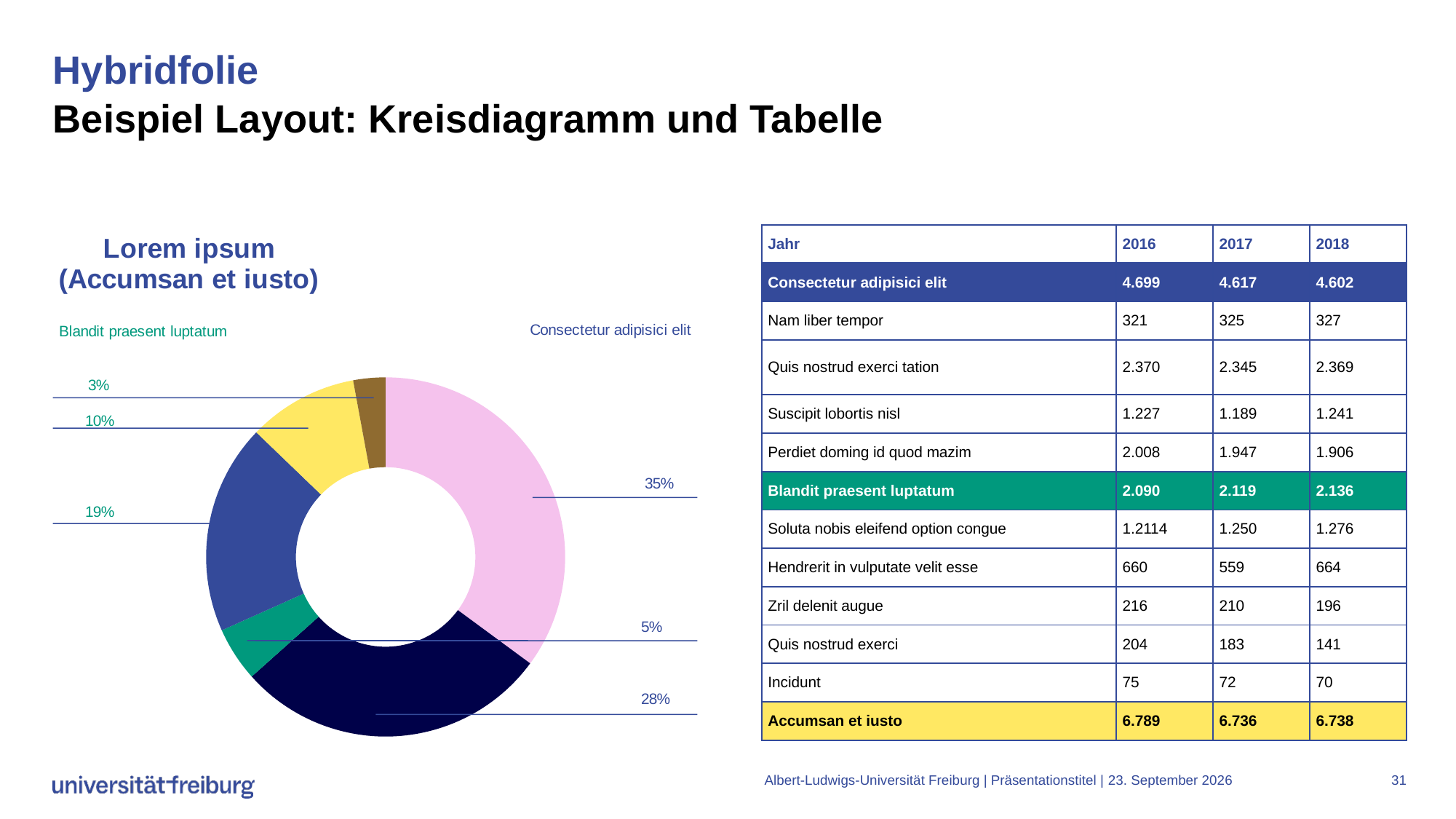
What colour is the 35% slice of the pie chart? pink In the pie chart, which is larger: the 19% slice or the 10% slice? 19% What is the difference between the largest slice (35%) and the second largest slice (28%) in the pie chart? 7% What is the smallest percentage shown on the pie chart? 3% How many slices does the pie chart have? 6 What is the largest percentage shown on the pie chart? 35% What is the sum of the 3%, 10% and 19% slices in the pie chart? 32% What percentage is shown for the dark navy slice at the bottom of the pie chart? 28% What is the difference between the 19% slice and the 5% slice in the pie chart? 14% Is the largest slice of the pie chart greater or less than 30%? greater What is the title of the pie chart? Lorem ipsum (Accumsan et iusto) What kind of chart is shown on the left of the slide? pie chart (donut)